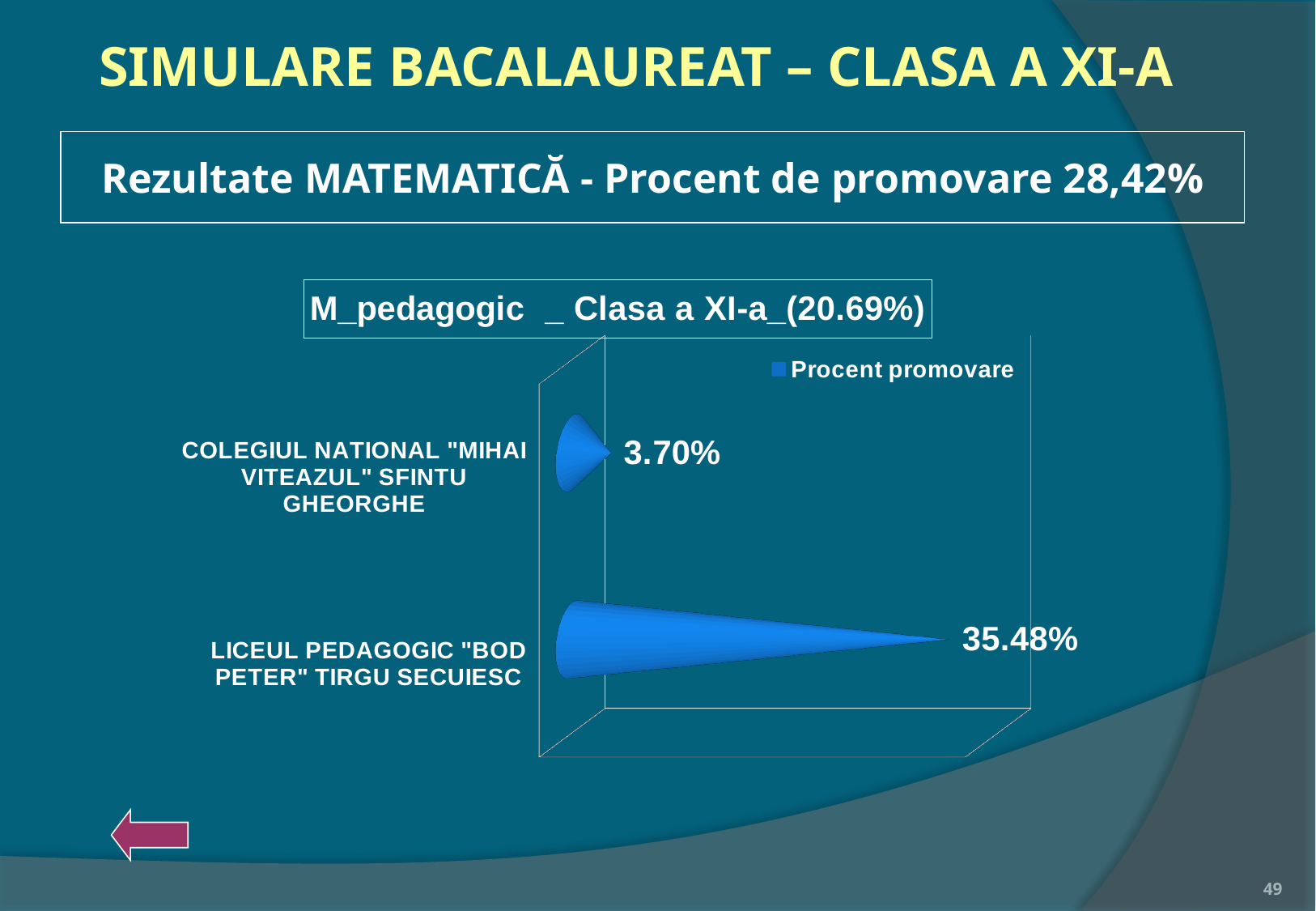
Which category has the lowest value? COLEGIUL NATIONAL "MIHAI VITEAZUL" SFINTU GHEORGHE How many categories are shown in the chart? 2 Which category has the highest value? LICEUL PEDAGOGIC "BOD PETER" TIRGU SECUIESC Which is larger: the value for COLEGIUL NATIONAL "MIHAI VITEAZUL" SFINTU GHEORGHE or the value for LICEUL PEDAGOGIC "BOD PETER" TIRGU SECUIESC? LICEUL PEDAGOGIC "BOD PETER" TIRGU SECUIESC What is the title of the chart? M_pedagogic _ Clasa a XI-a_(20.69%) What is the value for COLEGIUL NATIONAL "MIHAI VITEAZUL" SFINTU GHEORGHE? 3.70% What is the difference between the values for LICEUL PEDAGOGIC "BOD PETER" TIRGU SECUIESC and COLEGIUL NATIONAL "MIHAI VITEAZUL" SFINTU GHEORGHE? 31.78% What is the value for LICEUL PEDAGOGIC "BOD PETER" TIRGU SECUIESC? 35.48% What kind of chart is shown on the slide? Bar chart How many series does the legend list? 1 What is the name of the series listed in the legend? Procent promovare